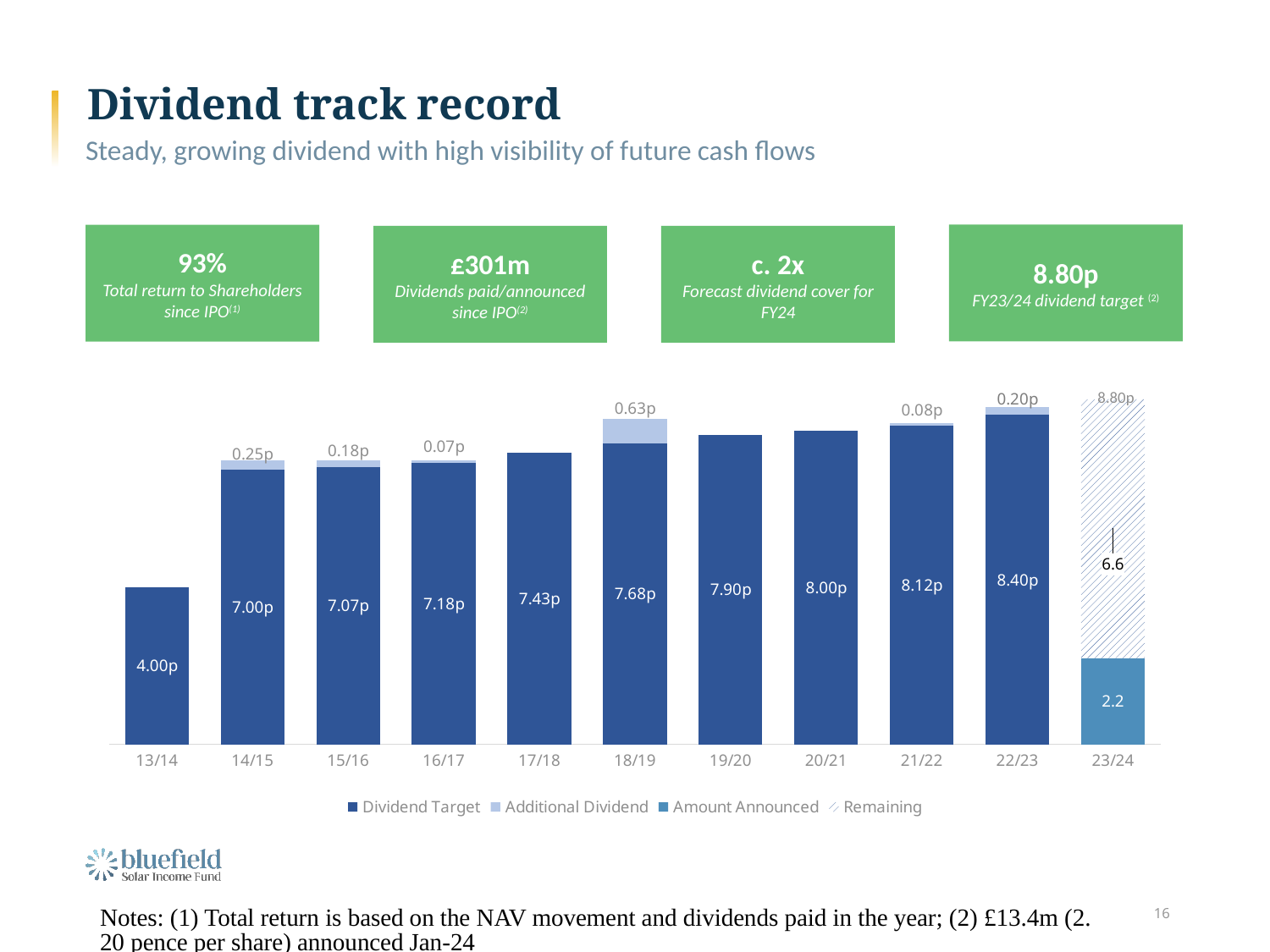
Which is larger, the Additional Dividend for 14/15 or for 15/16? 14/15 What kind of chart is shown on the slide? Stacked bar chart What is the Dividend Target value for 13/14? 4.00p What is the Dividend Target value for 22/23? 8.40p What is the Remaining value for 23/24? 6.6 Which year has the highest Additional Dividend? 18/19 How many years are shown on the x axis? 11 What is the Additional Dividend value for 18/19? 0.63p How many series does the legend list? 4 Which year has the lowest Dividend Target? 13/14 What is the Amount Announced value for 23/24? 2.2 What is the difference between the Dividend Target for 22/23 and 21/22? 0.28p